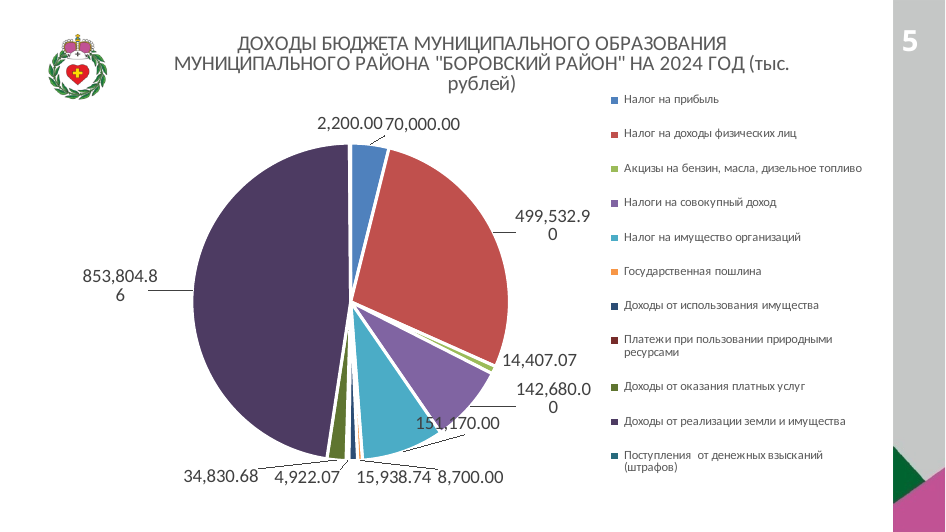
What is the smallest value shown on the pie chart? 2,200.00 What is the difference between the largest slice (853,804.86) and the "Налог на доходы физических лиц" slice (499,532.90)? 354,271.96 What is the value for "Налог на прибыль"? 70,000.00 What kind of chart is shown on the slide? pie chart Which category has the largest slice in the pie chart? Доходы от реализации земли и имущества How many categories does the legend of the pie chart list? 11 What is the value for "Доходы от реализации земли и имущества"? 853,804.86 What is the largest value shown on the pie chart? 853,804.86 Which is larger: "Налог на имущество организаций" (151,170.00) or "Налоги на совокупный доход" (142,680.00)? Налог на имущество организаций In what units are the values on the chart given, according to the title? тыс. рублей What is the value for "Налог на доходы физических лиц"? 499,532.90 How many data labels (slices) are shown on the pie chart? 11